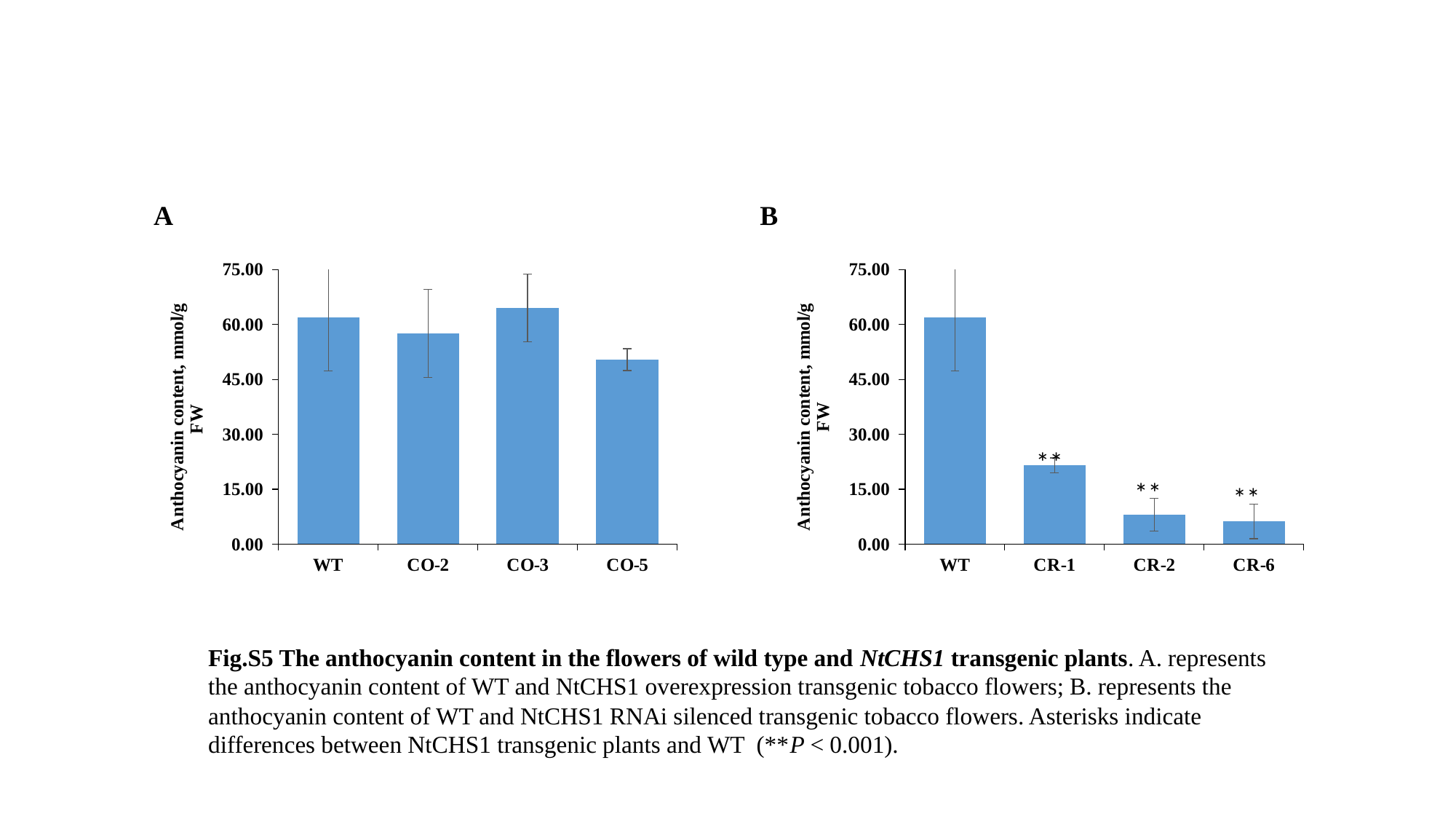
How many categories are shown on the x axis of chart B? 4 What is the y-axis label of chart B? Anthocyanin content, mmol/g FW In chart B, is the value for CR-2 greater or less than 15.00? less In chart A, which is larger, the value for CO-3 or the value for CO-5? CO-3 In chart B, is the value for CR-1 greater or less than 15.00? greater What kind of chart is chart A? bar chart In chart B, which category has the highest anthocyanin content? WT In chart B, do the values rise or fall moving from WT to CR-6 along the x axis? fall In chart A, is the value for CO-2 greater or less than 60.00? less In chart A, which category has the lowest anthocyanin content? CO-5 In chart B, which is larger, the value for CR-1 or the value for CR-2? CR-1